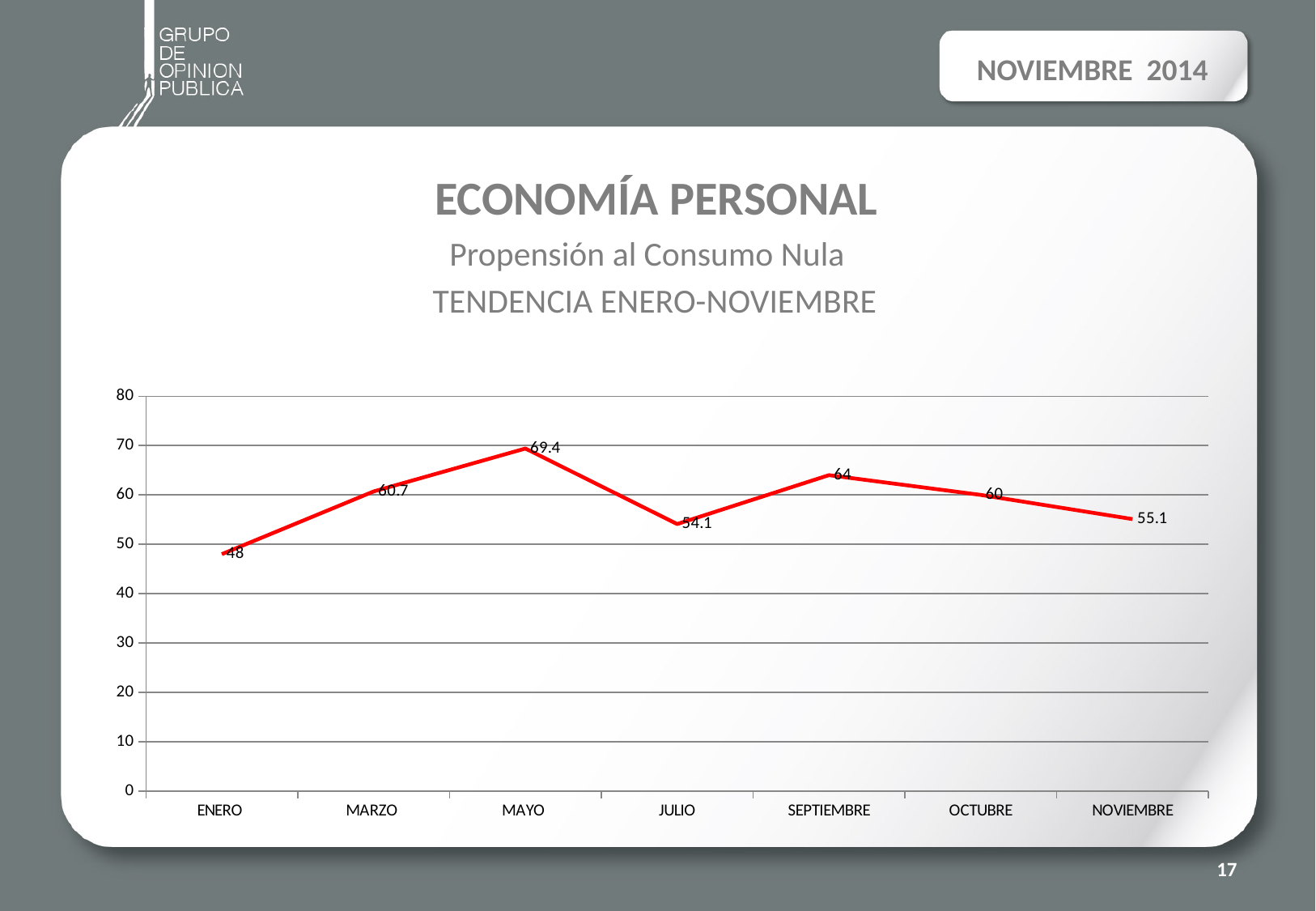
What kind of chart is shown? line chart What is the difference between the values for MAYO and JULIO? 15.3 What is the value for MAYO? 69.4 Which month has the highest value? MAYO What is the value for NOVIEMBRE? 55.1 What is the value for JULIO? 54.1 Which is larger, the value for SEPTIEMBRE or the value for OCTUBRE? SEPTIEMBRE Is the value for MARZO greater or less than 50? greater What is the value for ENERO? 48 Which month has the lowest value? ENERO How many months are plotted on the x axis? 7 Does the value rise or fall from OCTUBRE to NOVIEMBRE? fall